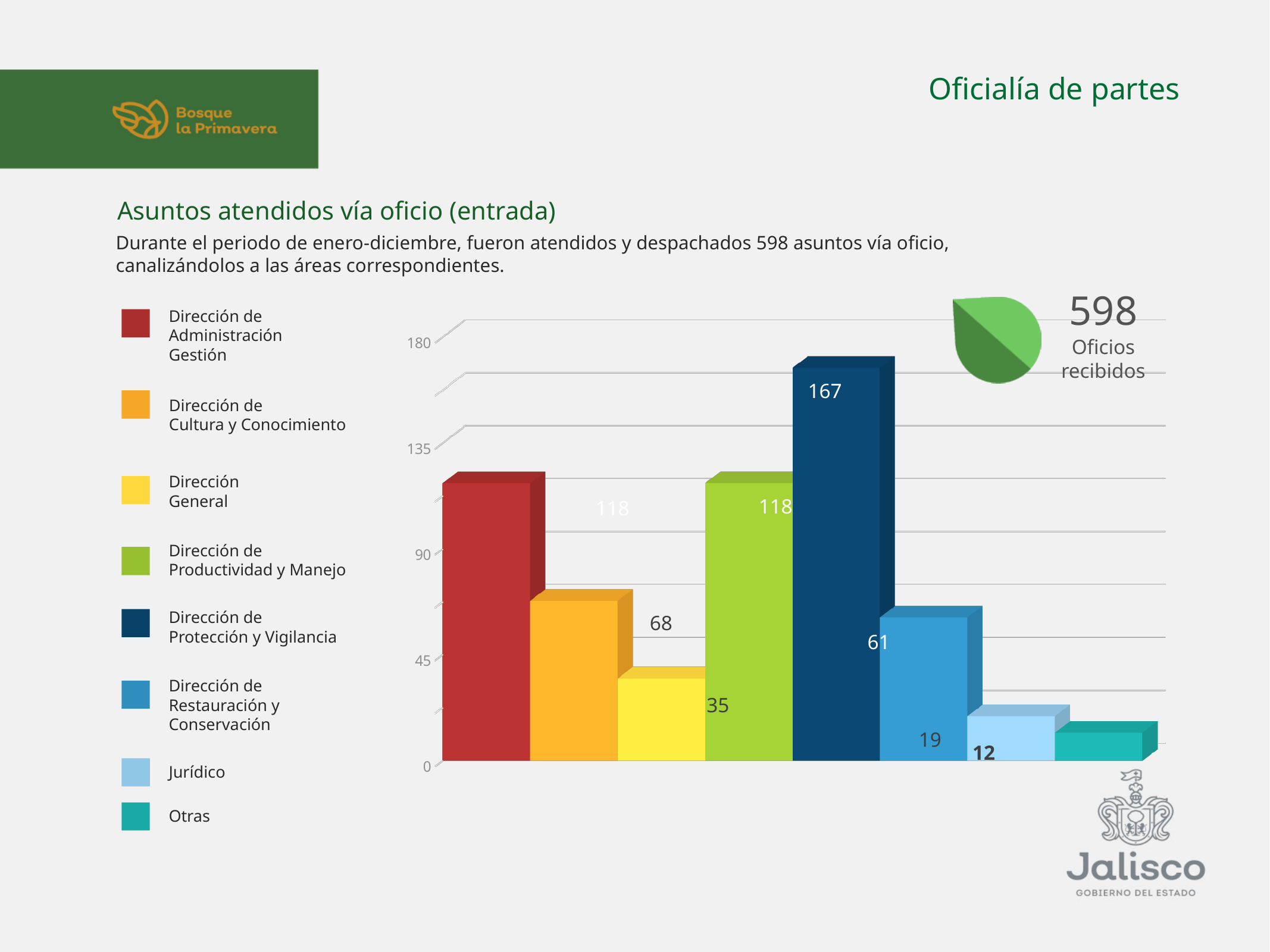
What value is shown for Dirección General? 35 What value is shown for Dirección de Protección y Vigilancia? 167 What kind of chart is shown on the slide? Bar chart How many bars are plotted in the chart? 8 What is the difference between the values for Dirección de Protección y Vigilancia and Dirección de Administración Gestión? 49 What value is shown for Dirección de Restauración y Conservación? 61 Which category has the highest value? Dirección de Protección y Vigilancia What total number of oficios recibidos is shown next to the chart? 598 Which is larger, the value for Dirección de Cultura y Conocimiento or the value for Dirección de Restauración y Conservación? Dirección de Cultura y Conocimiento What value is shown for Dirección de Cultura y Conocimiento? 68 Which category has the lowest value? Otras Is the value for Dirección de Productividad y Manejo greater or less than 90? greater